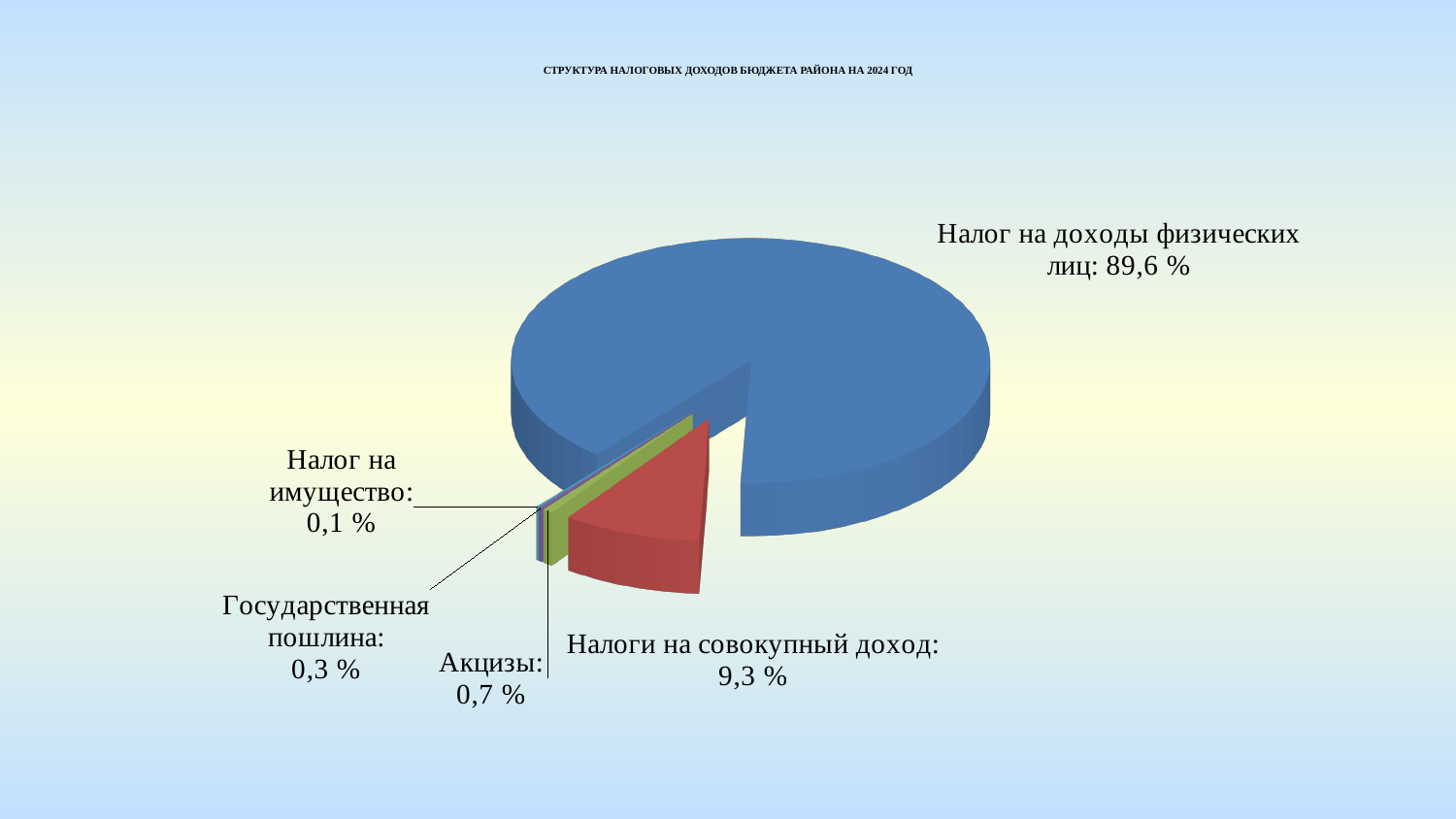
Which category has the largest share of the pie? Налог на доходы физических лиц How many slices does the pie chart have? 5 What share of the pie is labelled for "Налог на доходы физических лиц"? 89,6 % Which category has the smallest share of the pie? Налог на имущество What type of chart is shown on the slide? Pie chart Which is larger: the share for "Акцизы" or the share for "Государственная пошлина"? Акцизы What value is shown for "Налог на имущество"? 0,1 % What value is shown for "Акцизы"? 0,7 % What value is shown for "Государственная пошлина"? 0,3 % What value is shown for "Налоги на совокупный доход"? 9,3 % What is the title of the chart on the slide? СТРУКТУРА НАЛОГОВЫХ ДОХОДОВ БЮДЖЕТА РАЙОНА НА 2024 ГОД What is the difference between the shares of "Налог на доходы физических лиц" and "Налоги на совокупный доход"? 80,3 %